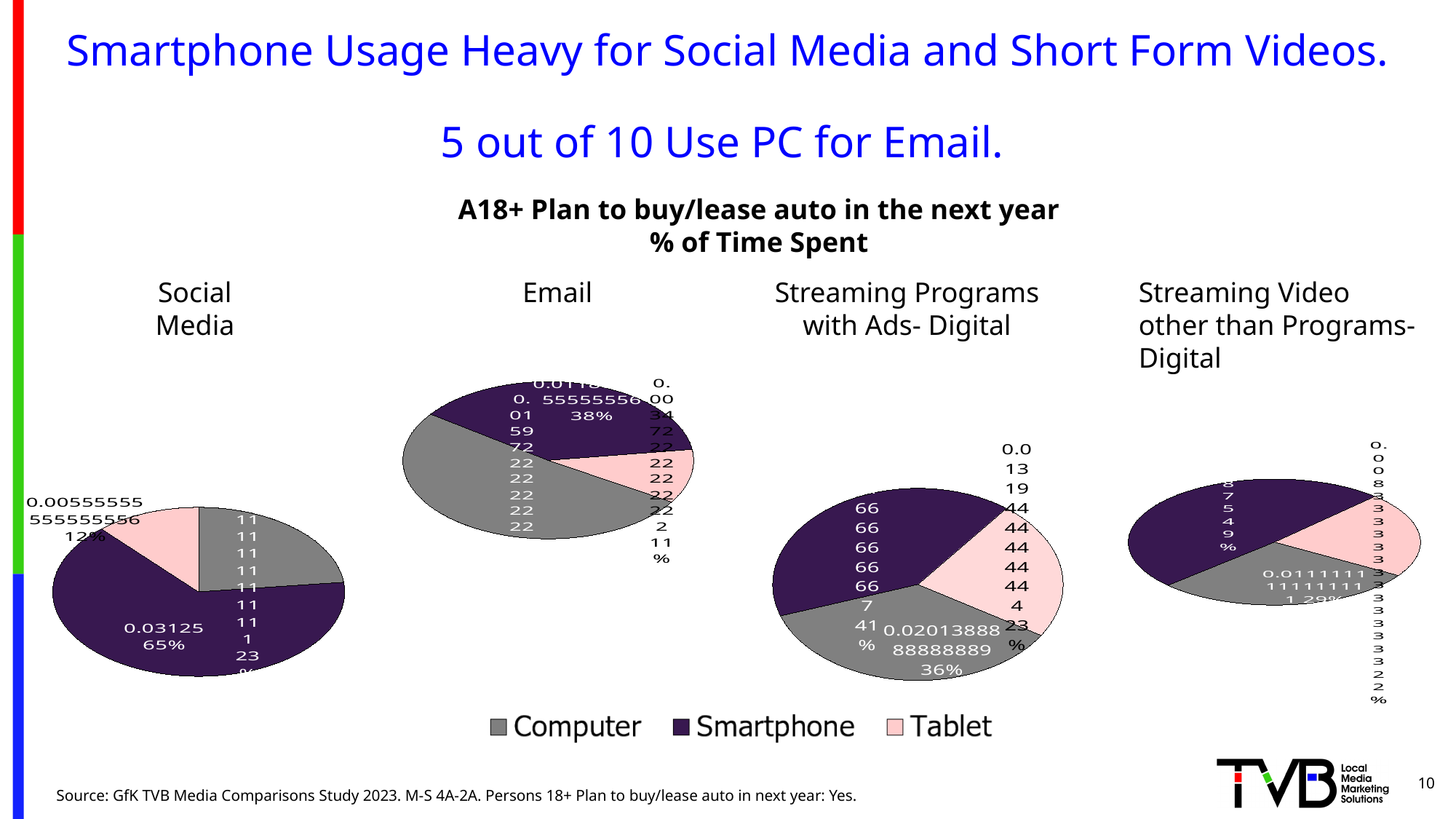
In the Social Media chart, which device has the largest share? Smartphone In the Social Media chart, how many percentage points larger is the Smartphone share than the Tablet share? 53 In the Email chart, what share of time spent is Smartphone? 38% In the Social Media chart, what share of time spent is Tablet? 12% In the Streaming Programs with Ads- Digital chart, what share of time spent is Computer? 36% What kind of chart is used for the Social Media chart? pie chart How many series does the legend list? 3 In the Streaming Programs with Ads- Digital chart, which device has the smallest share? Tablet In the Streaming Programs with Ads- Digital chart, what share of time spent is Smartphone? 41% In the Social Media chart, what share of time spent is Smartphone? 65% In the Email chart, what share of time spent is Tablet? 11% In the Email chart, which device has the largest share? Computer